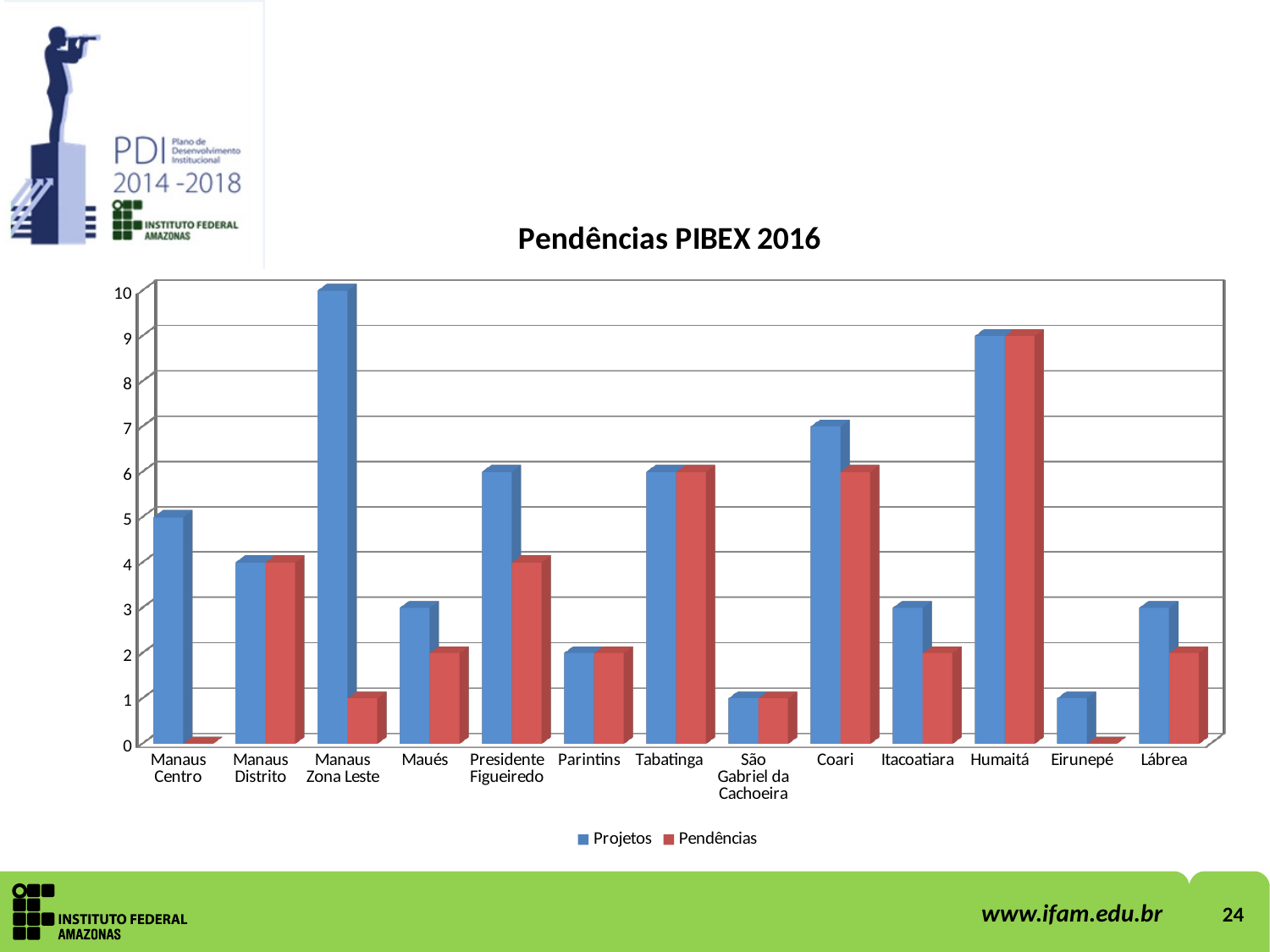
What is the Projetos value for Coari? 7 Which colour represents the Pendências series? red Which category has the highest Projetos value? Manaus Zona Leste How many series does the legend list? 2 What is the title of the chart? Pendências PIBEX 2016 What is the Pendências value for Humaitá? 9 How many categories are shown on the x axis? 13 Which is larger for Coari, Projetos or Pendências? Projetos What type of chart is shown on the slide? bar chart Which category has the highest Pendências value? Humaitá Is the Projetos value for Manaus Zona Leste greater or less than 8? greater What is the Projetos value for Manaus Zona Leste? 10